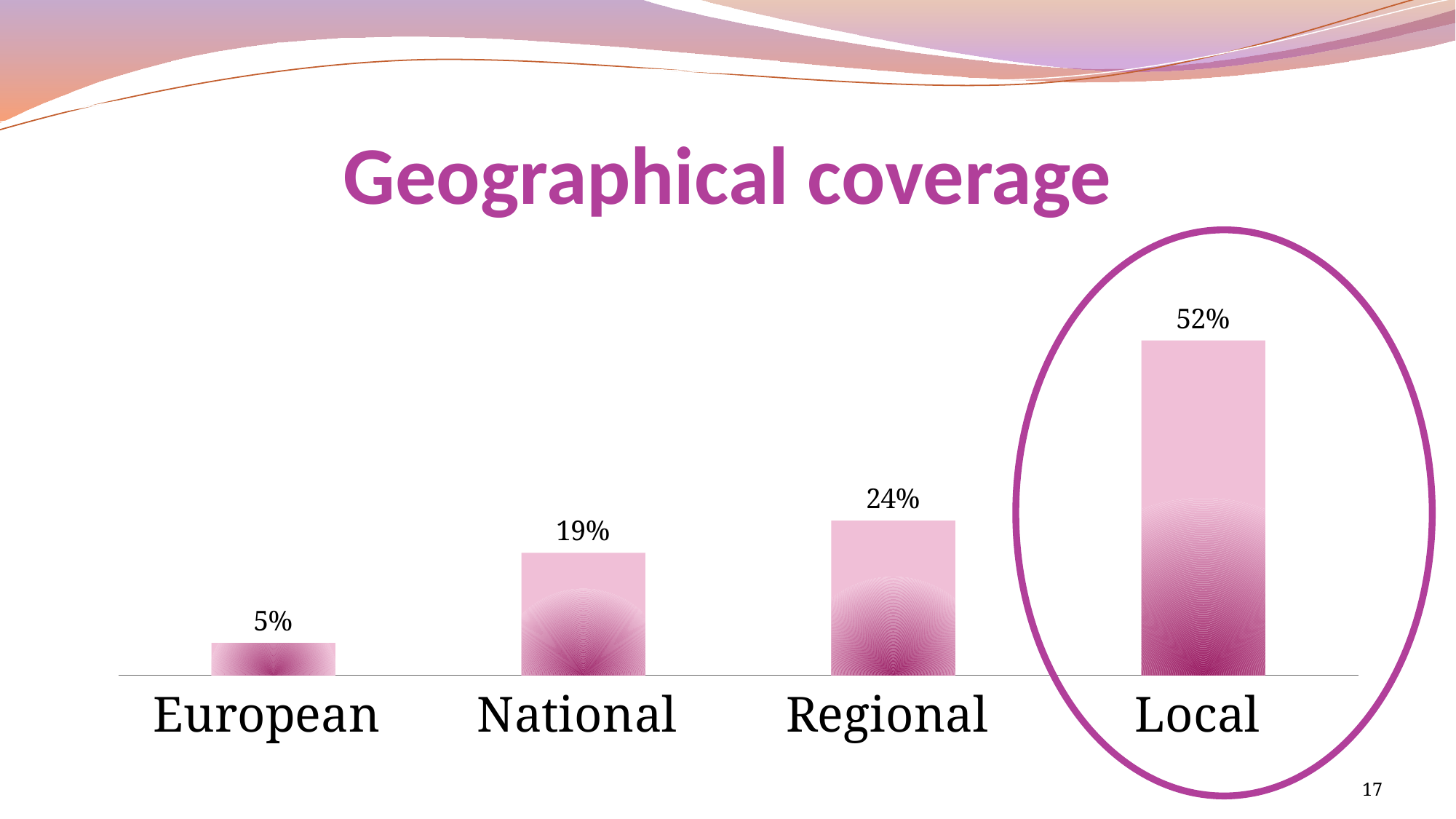
What is the value for Local? 52% What is the difference between the values for Local and Regional? 28% Which is larger, the value for Regional or the value for National? Regional Do the values rise or fall from European to Local along the x axis? Rise What is the value for Regional? 24% What is the value for National? 19% Which category has the lowest value? European What kind of chart is shown on the slide? Bar chart How many categories are shown in the chart? 4 Which category has the highest value? Local What is the difference between the values for National and European? 14% What is the value for European? 5%